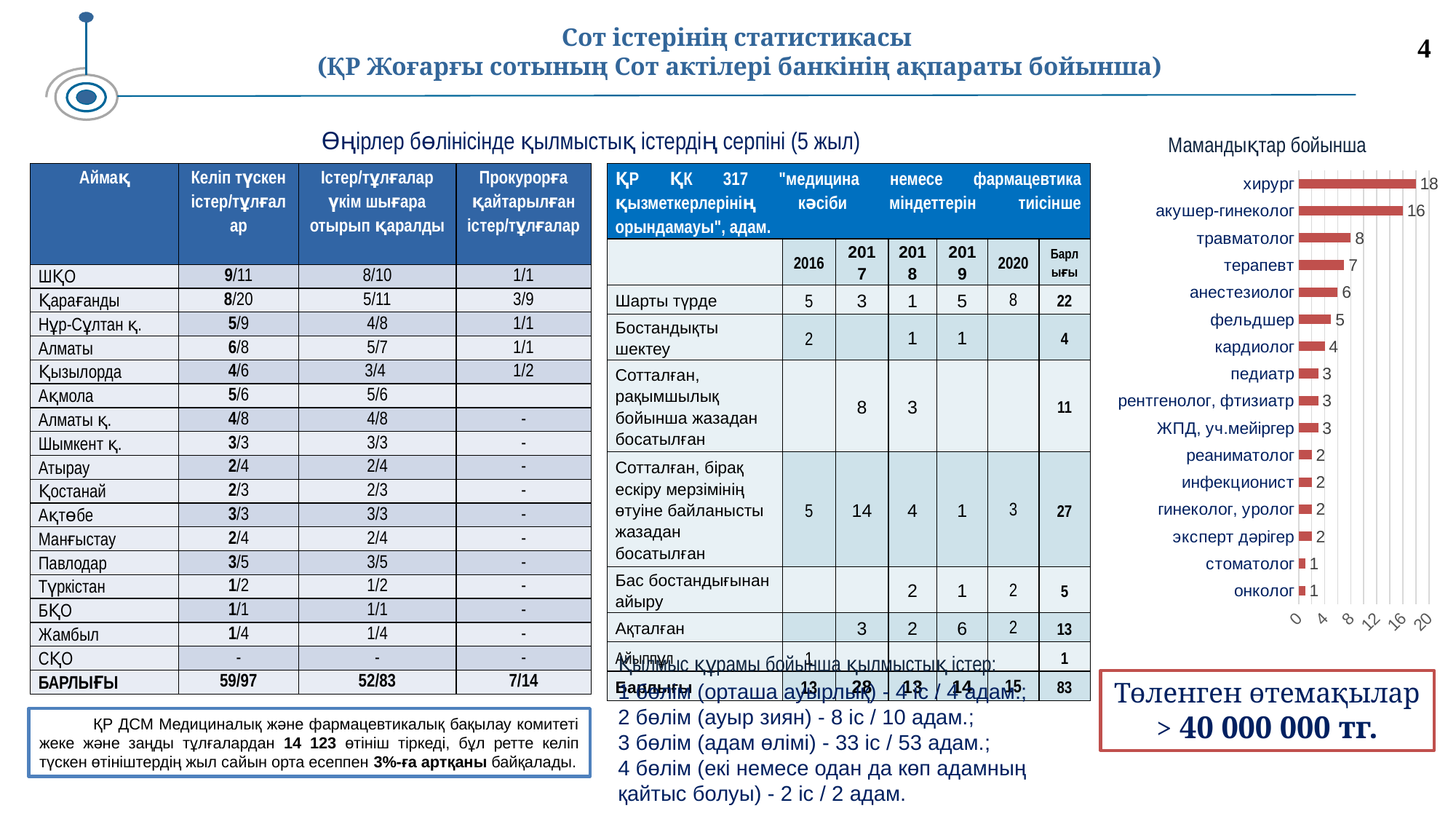
How many categories are shown in the "Мамандықтар бойынша" chart? 16 What kind of chart is shown under the title "Мамандықтар бойынша"? bar chart In the "Мамандықтар бойынша" chart, what is the difference between the values for травматолог and терапевт? 1 In the "Мамандықтар бойынша" chart, which is larger: the value for анестезиолог or the value for кардиолог? анестезиолог In the "Мамандықтар бойынша" chart, what is the value for хирург? 18 In the "Мамандықтар бойынша" chart, is the value for акушер-гинеколог greater or less than 12? greater In the "Мамандықтар бойынша" chart, what is the value for онколог? 1 In the "Мамандықтар бойынша" chart, what is the value for травматолог? 8 In the "Мамандықтар бойынша" chart, which category has the highest value? хирург In the "Мамандықтар бойынша" chart, what is the value for акушер-гинеколог? 16 In the "Мамандықтар бойынша" chart, what is the difference between the values for хирург and акушер-гинеколог? 2 In the "Мамандықтар бойынша" chart, what is the value for фельдшер? 5